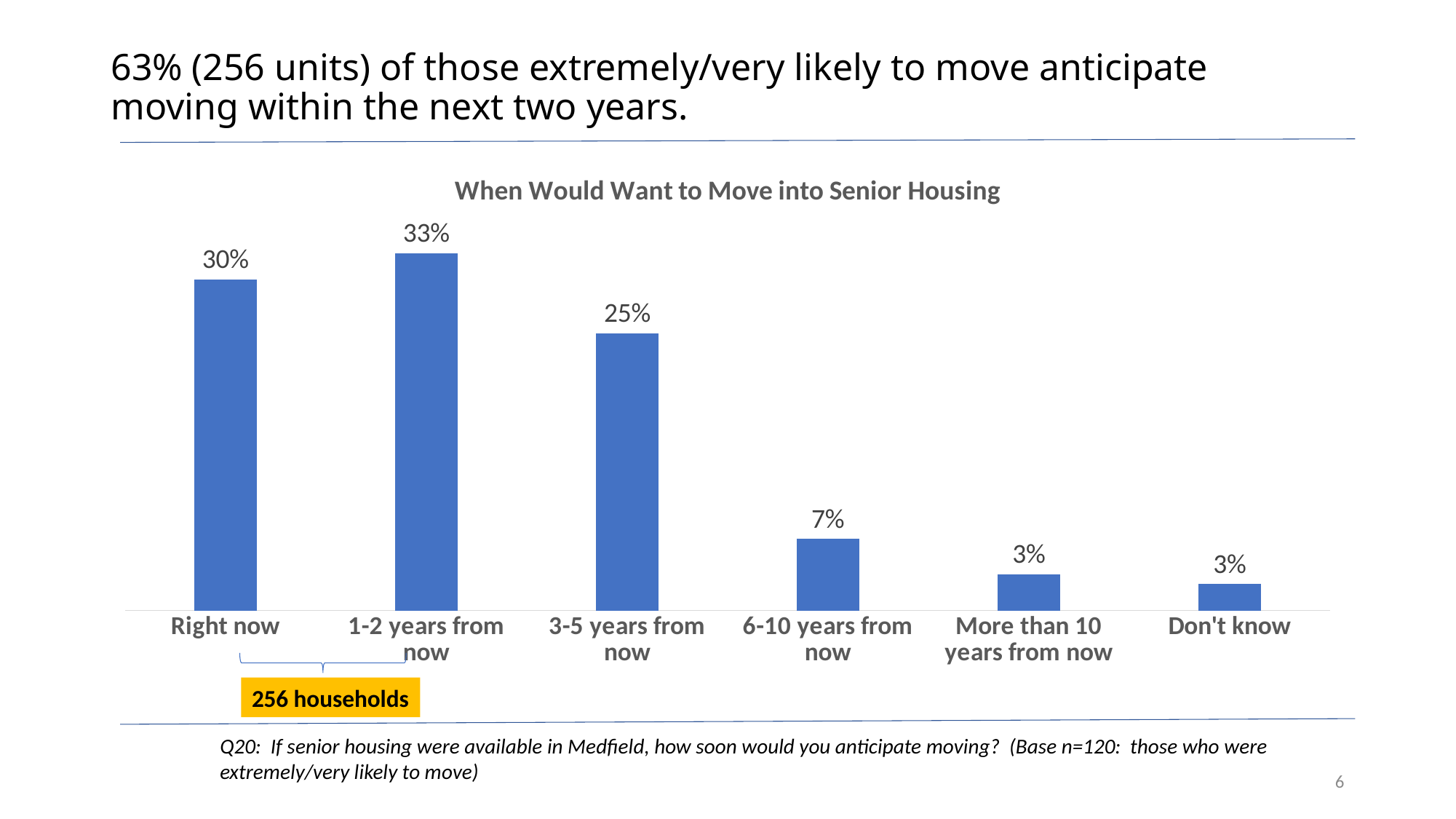
Which category has the highest value? 1-2 years from now What is the value for "Don't know"? 3% What is the value for "1-2 years from now"? 33% What is the difference between the values for "1-2 years from now" and "Right now"? 3% How many categories are shown on the x axis? 6 What kind of chart is shown on the slide? Bar chart What is the value for "3-5 years from now"? 25% What is the difference between the values for "3-5 years from now" and "6-10 years from now"? 18% Which is larger, the value for "Right now" or the value for "3-5 years from now"? Right now What is the value for "Right now"? 30% What is the value for "6-10 years from now"? 7% What is the title of the chart? When Would Want to Move into Senior Housing